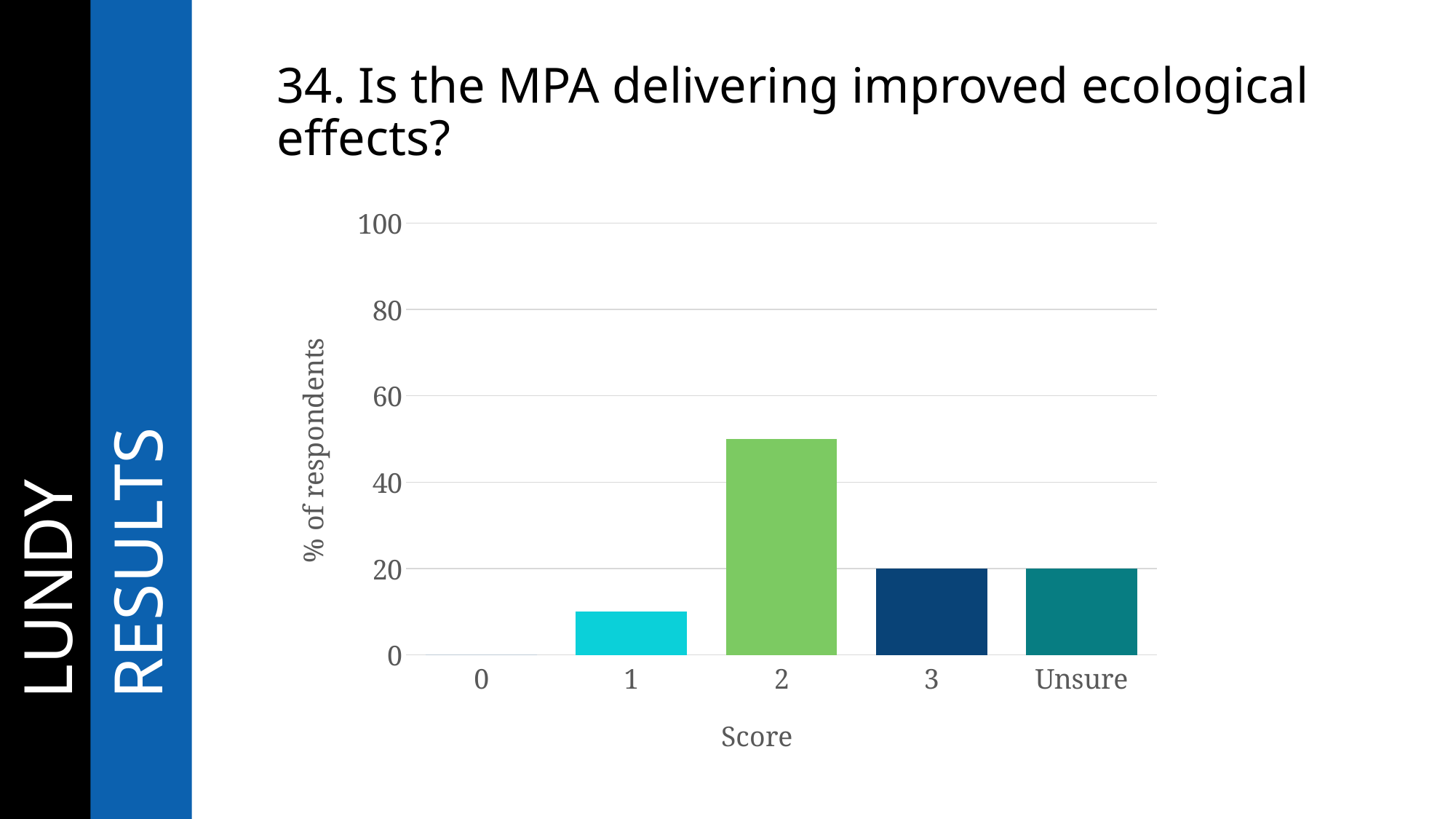
Is the value for score 2 greater or less than 60? less Is the value for score 2 greater or less than 40? greater Which has a higher percentage of respondents, score 1 or score 3? 3 What is the label on the y axis? % of respondents What kind of chart is shown on the slide? bar chart What is the percentage of respondents for Unsure? 20 What is the percentage of respondents for score 3? 20 Which score category has the lowest percentage of respondents? 0 Is the value for score 1 greater or less than 20? less How many score categories are shown on the x axis? 5 Which score category has the highest percentage of respondents? 2 What is the label on the x axis? Score